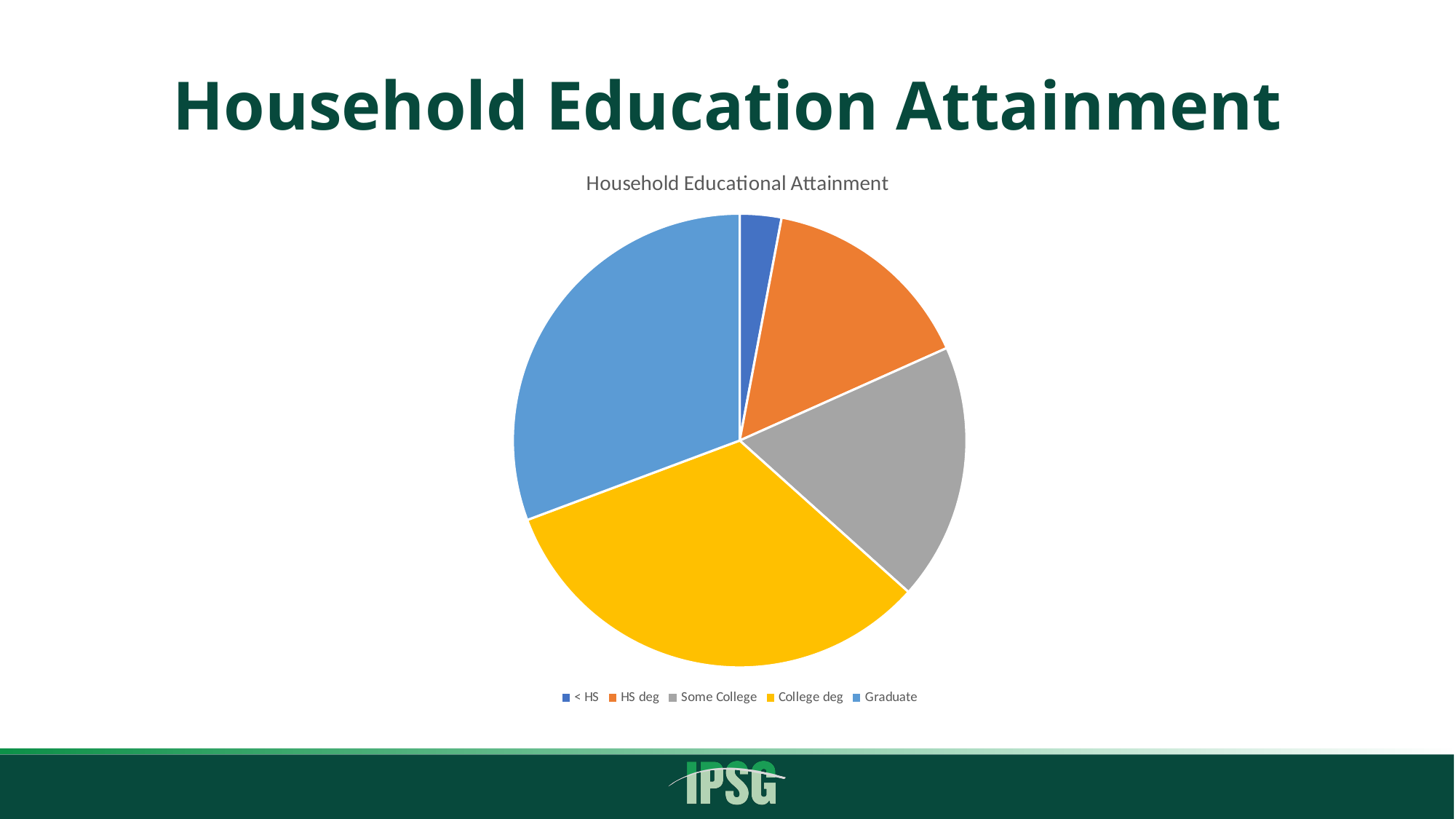
Which category has the smallest slice of the pie? < HS How many categories does the pie chart show? 5 Which slice is larger, College deg or HS deg? College deg What kind of chart is shown on the slide? pie chart Which category is shown in yellow in the pie chart? College deg What is the title of the chart? Household Educational Attainment Which slice is larger, Some College or < HS? Some College Which slice is larger, Graduate or < HS? Graduate